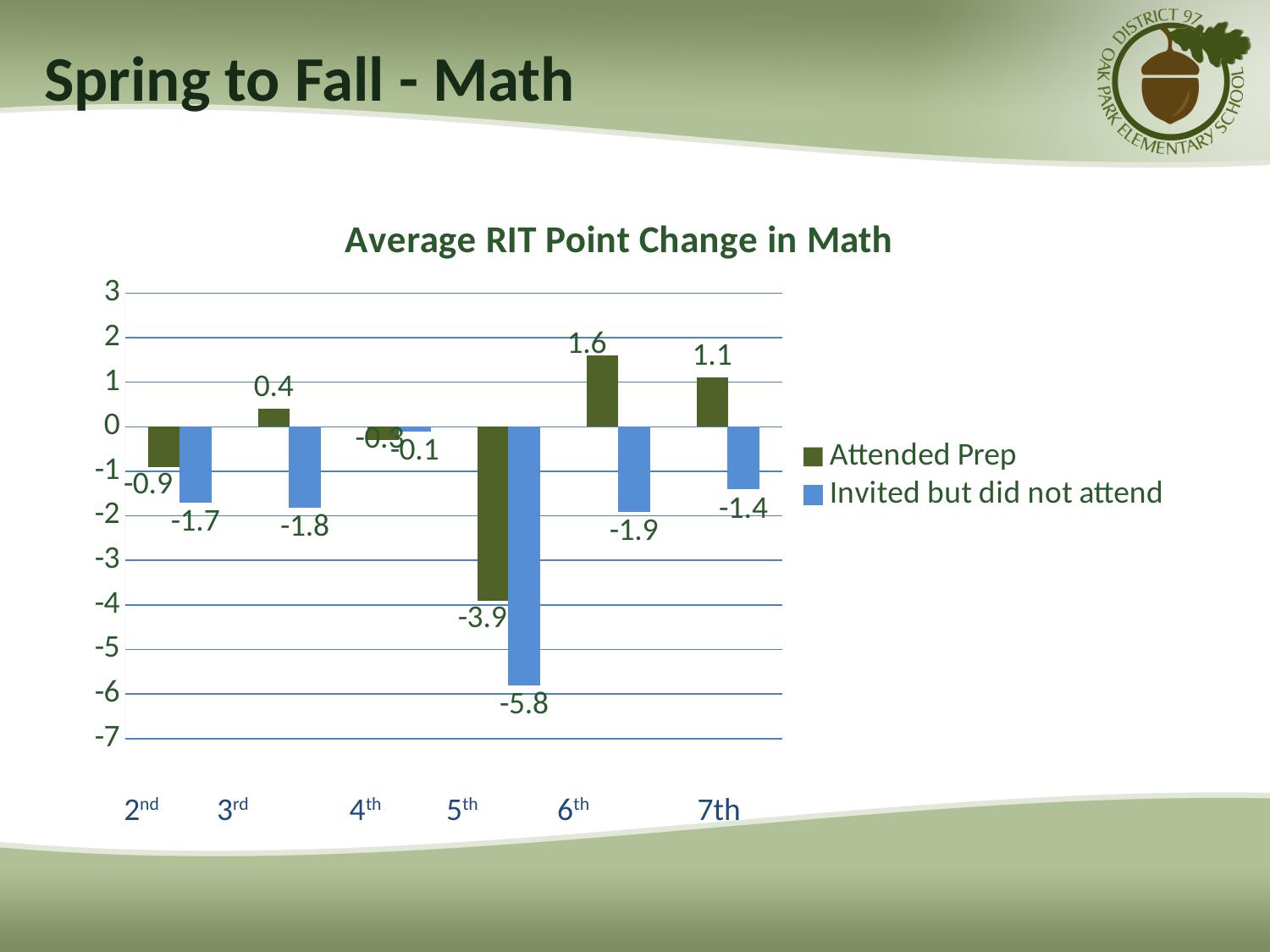
In 7th grade, which series has the larger value, Attended Prep or Invited but did not attend? Attended Prep What is the Attended Prep value for 3rd grade? 0.4 What is the title of the chart? Average RIT Point Change in Math In 6th grade, what is the difference between the Attended Prep value and the Invited but did not attend value? 3.5 Which grade has the highest Attended Prep value? 6th What is the value for Invited but did not attend in 5th grade? -5.8 In 5th grade, what is the difference between the Attended Prep value and the Invited but did not attend value? 1.9 Which grade has the lowest value for Invited but did not attend? 5th How many grade categories are shown on the x axis? 6 How many series does the legend list? 2 What kind of chart is shown on the slide? Bar chart What is the Attended Prep value for 6th grade? 1.6